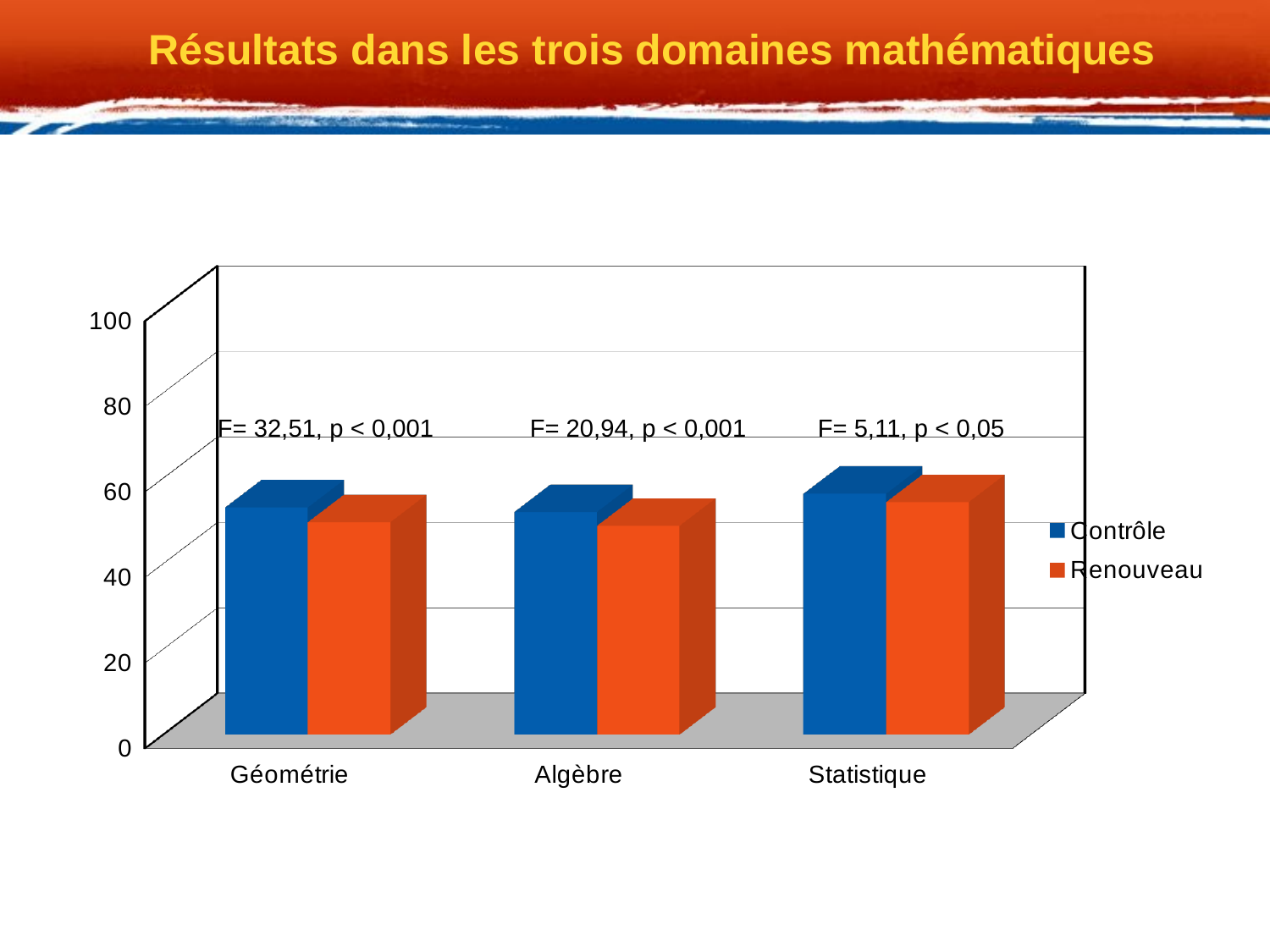
Is the Contrôle value for Géométrie greater or less than 40? greater Which category has the highest Renouveau value? Statistique How many series does the chart's legend list? 2 What are the two series listed in the chart's legend? Contrôle and Renouveau What kind of chart is shown on the slide? bar chart Which category has the highest Contrôle value? Statistique Is the Contrôle value for Statistique greater or less than 80? less What is the title of the slide containing the chart? Résultats dans les trois domaines mathématiques How many categories are shown on the x axis of the chart? 3 For Algèbre, which series has the larger value, Contrôle or Renouveau? Contrôle Is the Renouveau value for Algèbre greater or less than 40? greater For Géométrie, which series has the larger value, Contrôle or Renouveau? Contrôle